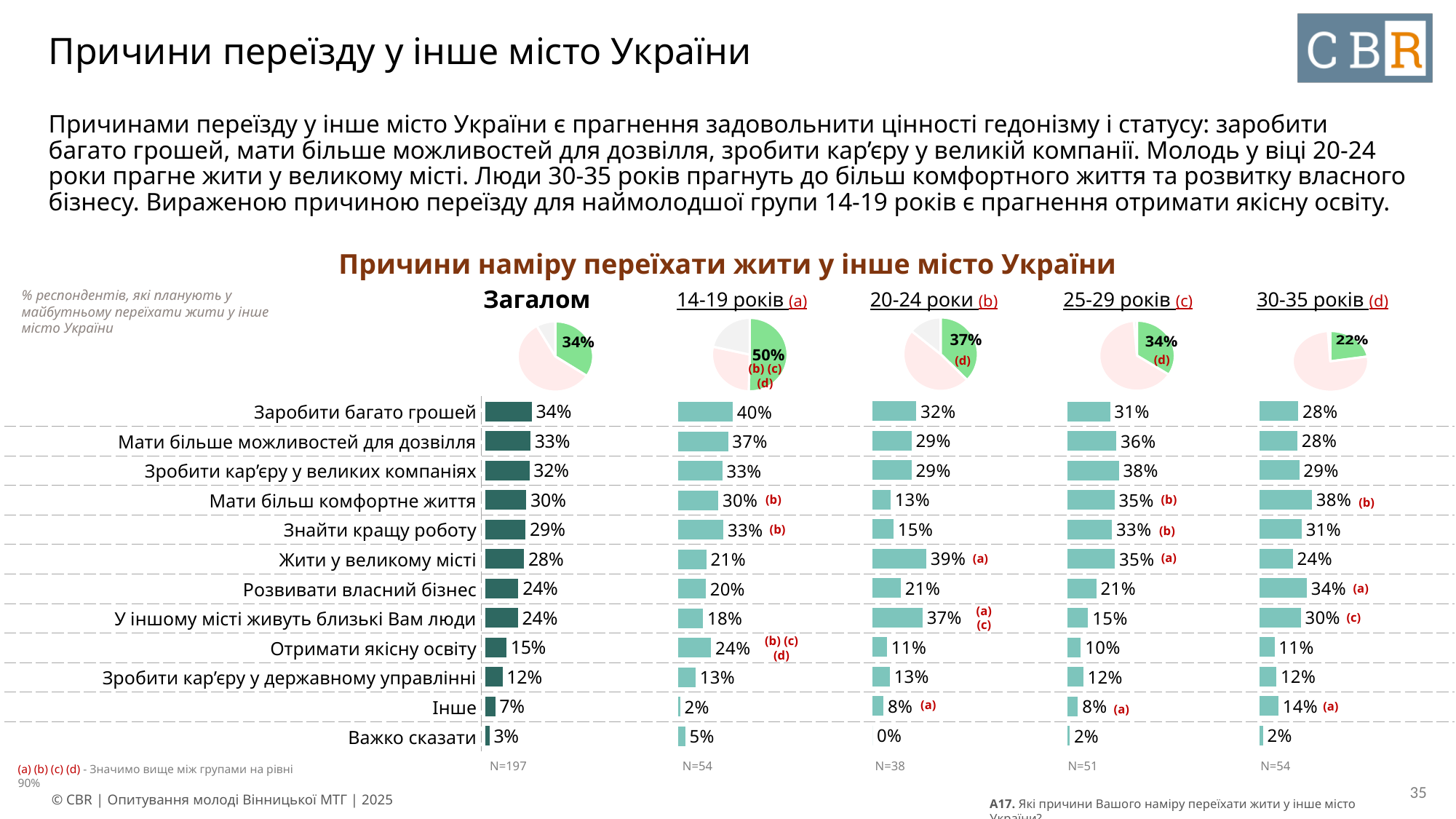
In the '30-35 років' bar chart, which category has the highest value? Мати більш комфортне життя What kind of chart is used to show the reasons in the 'Загалом' column? Bar chart In the '20-24 роки' bar chart, what is the value for 'Важко сказати'? 0% In the '14-19 років' bar chart, what is the value for 'Отримати якісну освіту'? 24% In the 'Загалом' bar chart, what is the value for 'Заробити багато грошей'? 34% How many categories are listed in the 'Загалом' bar chart? 12 In the pie chart for '14-19 років', what share is shown for the green slice? 50% In the 'Загалом' bar chart, what is the difference between 'Заробити багато грошей' and 'Отримати якісну освіту'? 19 percentage points In the 'Загалом' bar chart, which category has the lowest value? Важко сказати In the '25-29 років' bar chart, which is larger: 'Зробити кар’єру у великих компаніях' or 'Заробити багато грошей'? Зробити кар’єру у великих компаніях In the '20-24 роки' bar chart, which category has the highest value? Жити у великому місті In the pie chart for '30-35 років', what share is shown for the green slice? 22%